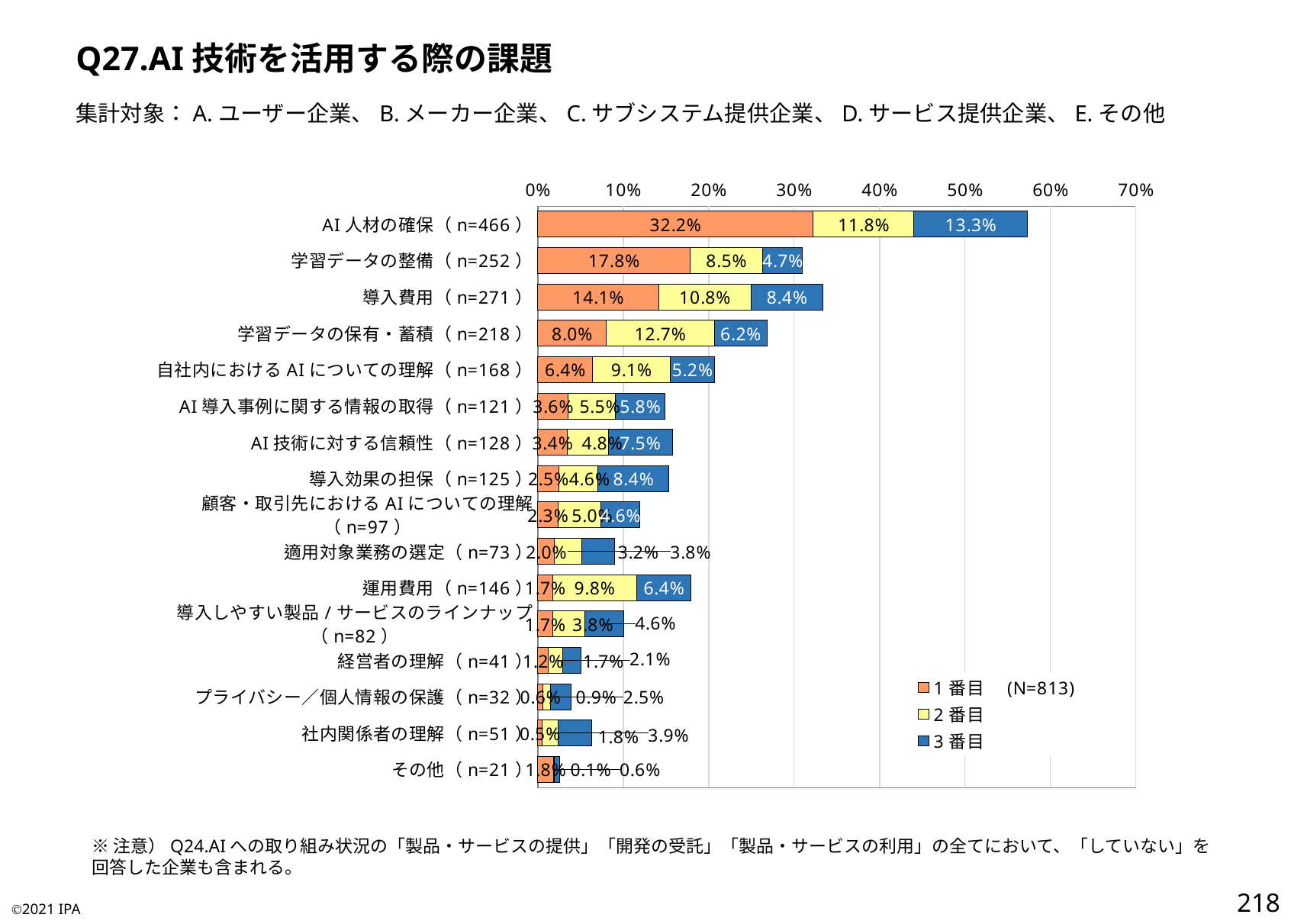
How many series does the legend list? 3 What is the 3番目 value for 導入費用 (n=271)? 8.4% What is the difference between the 1番目 values for AI 人材の確保 (n=466) and 学習データの整備 (n=252)? 14.4 percentage points What N value is shown next to the legend? N=813 Which is larger: the 2番目 value for 運用費用 (n=146) or the 2番目 value for 自社内における AI についての理解 (n=168)? 運用費用 (n=146) What is the 1番目 value for AI 人材の確保 (n=466)? 32.2% How many categories are shown on the chart? 16 What is the 2番目 value for 学習データの保有・蓄積 (n=218)? 12.7% Which category has the highest 1番目 value? AI 人材の確保 (n=466) Is the total stacked bar for AI 人材の確保 (n=466) greater or less than 50%? greater What is the total of the stacked bar for 導入費用 (n=271)? 33.3% What kind of chart is shown on the slide? Stacked horizontal bar chart